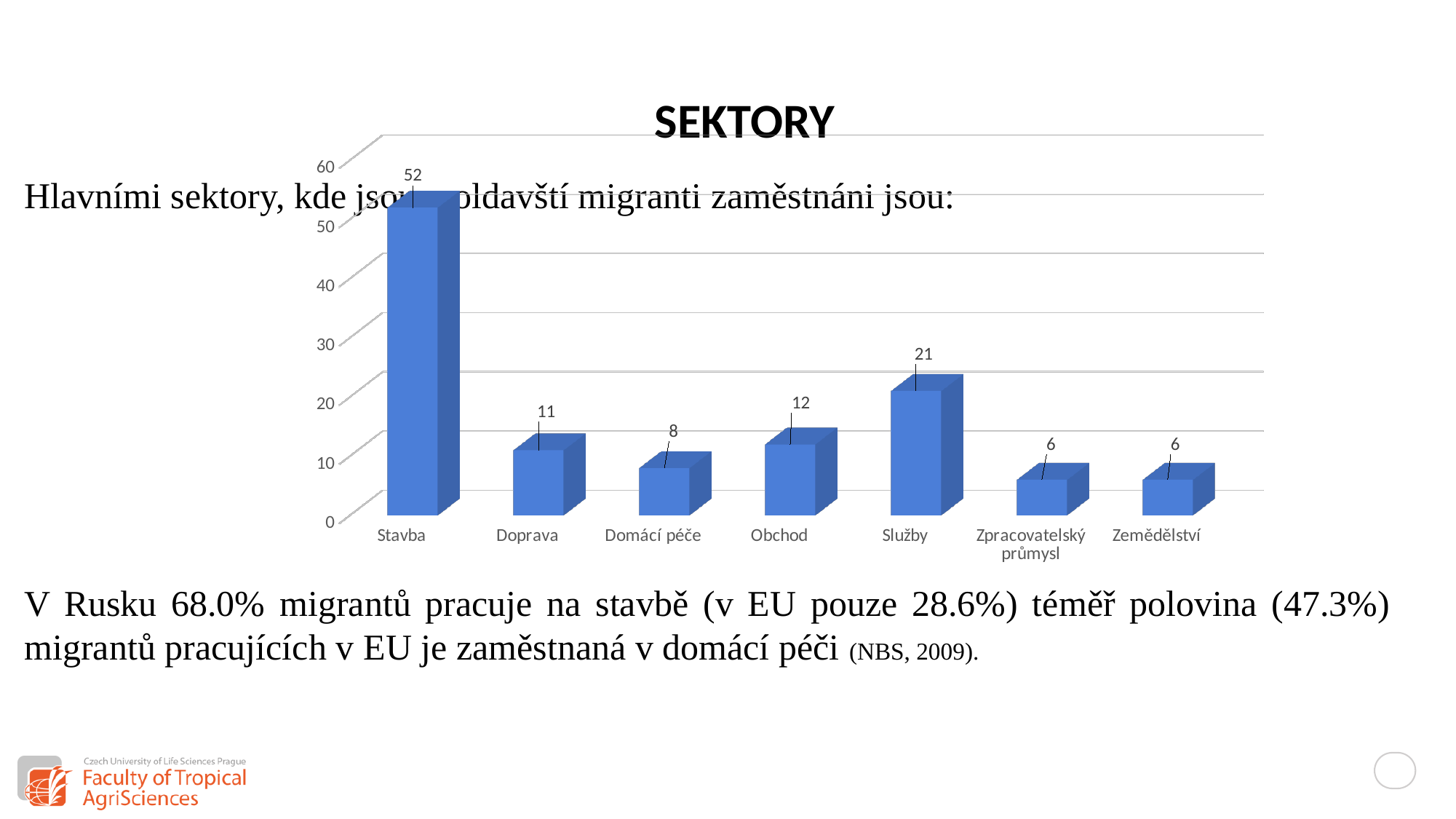
Which is larger, the value for Doprava or the value for Obchod? Obchod What is the value for Obchod? 12 Is the value for Služby greater or less than 20? greater What is the value for Služby? 21 What kind of chart is shown on the slide? bar chart How many categories are shown on the x axis? 7 What is the difference between the values for Doprava and Zemědělství? 5 What is the difference between the values for Stavba and Služby? 31 What is the title of the chart? SEKTORY What is the value for Domácí péče? 8 Which category has the highest value? Stavba What is the value for Stavba? 52